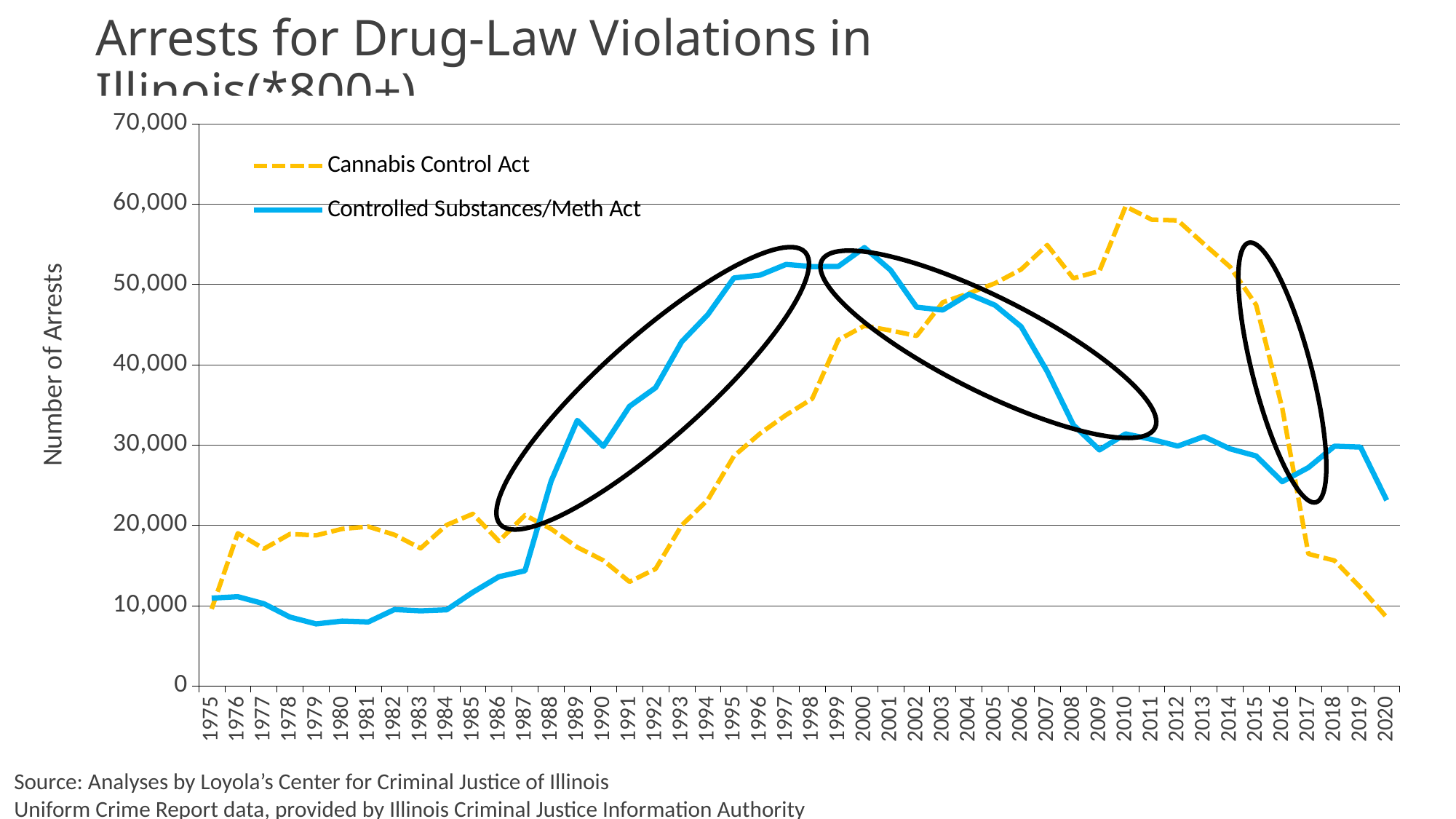
Is the value for Cannabis Control Act in 2020 greater or less than 10,000? less How many series does the legend list? 2 In 1995, which series has the higher number of arrests? Controlled Substances/Meth Act Is the value for Controlled Substances/Meth Act in 1979 greater or less than 10,000? less How many years are plotted along the x axis? 46 Do the Cannabis Control Act arrests rise or fall from 2010 to 2020? fall Is the value for Controlled Substances/Meth Act in 2020 greater or less than 20,000? greater In 2010, which series has the higher number of arrests? Cannabis Control Act What kind of chart is shown on the slide? line chart What is the title of the y axis? Number of Arrests